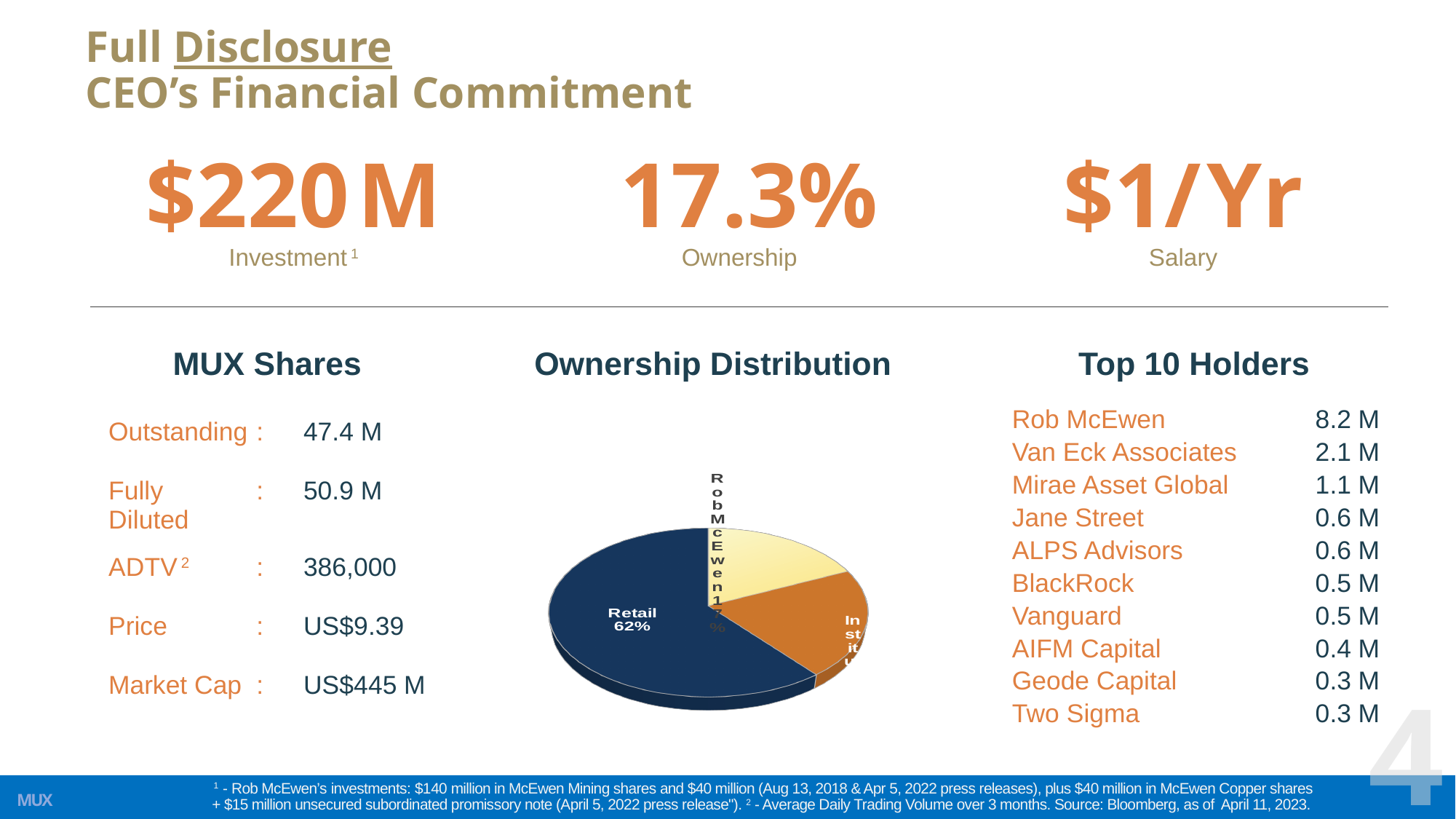
In the Ownership Distribution pie chart, does the Retail slice account for more or less than half of the pie? more Which slice is the largest in the Ownership Distribution pie chart? Retail What colour is the Retail slice in the Ownership Distribution pie chart? dark blue In the Ownership Distribution pie chart, which slice is larger: Retail or Rob McEwen? Retail How many slices does the Ownership Distribution pie chart have? 3 In the Ownership Distribution pie chart, what share is labelled for Retail? 62% What is the title of the pie chart on the slide? Ownership Distribution What kind of chart is shown under the heading "Ownership Distribution"? pie chart